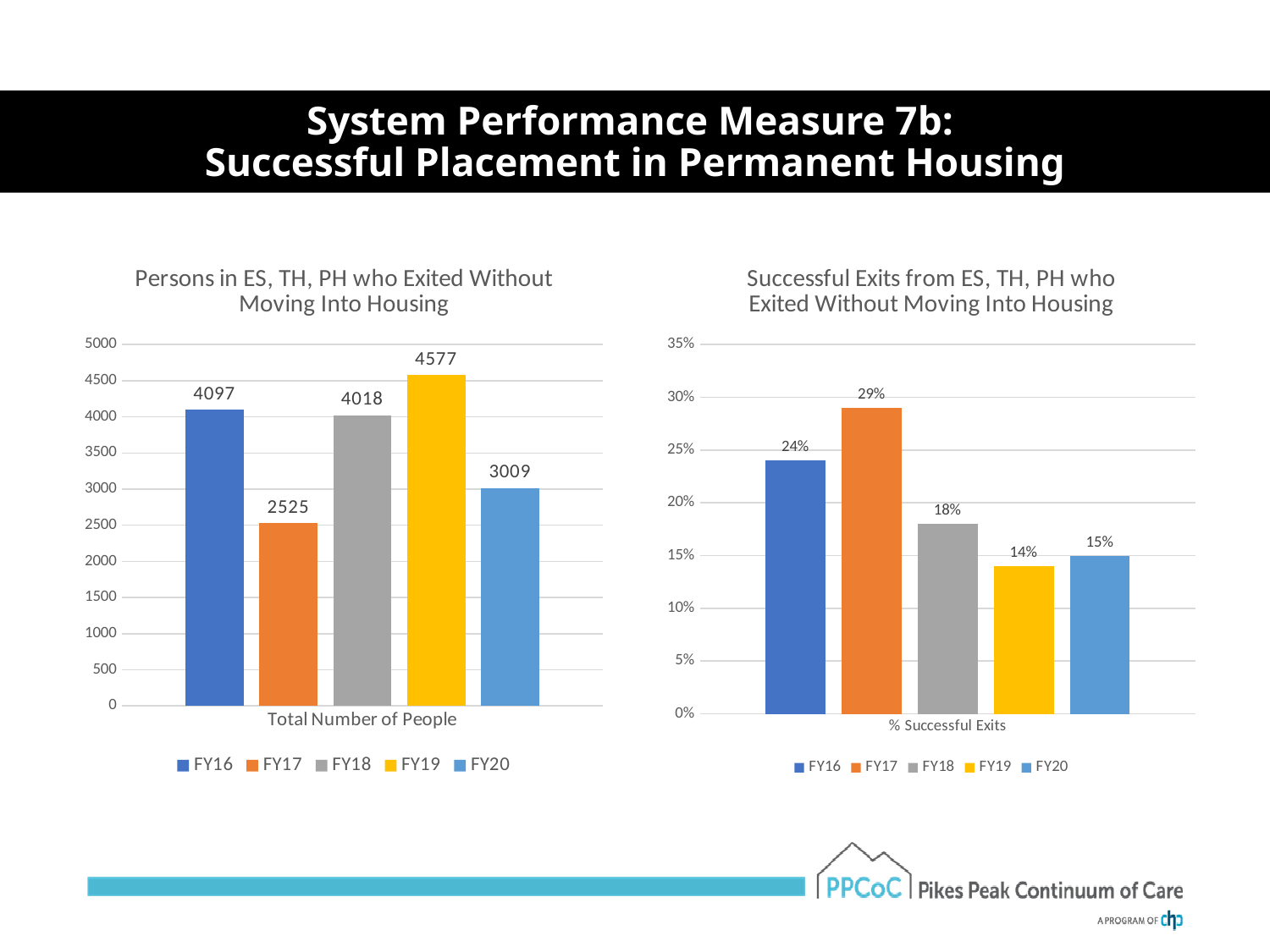
In the left chart (Persons in ES, TH, PH who Exited Without Moving Into Housing), how many series does the legend list? 5 In the right chart (Successful Exits from ES, TH, PH who Exited Without Moving Into Housing), which fiscal year has the highest percentage? FY17 In the left chart (Persons in ES, TH, PH who Exited Without Moving Into Housing), which fiscal year has the highest value? FY19 In the right chart (Successful Exits from ES, TH, PH who Exited Without Moving Into Housing), which fiscal year has the lowest percentage? FY19 In the right chart (Successful Exits from ES, TH, PH who Exited Without Moving Into Housing), what is the difference between the FY16 and FY20 values? 9% In the left chart (Persons in ES, TH, PH who Exited Without Moving Into Housing), what is the difference between the FY19 and FY20 values? 1568 What kind of chart is the right chart (Successful Exits from ES, TH, PH who Exited Without Moving Into Housing)? Bar chart In the left chart (Persons in ES, TH, PH who Exited Without Moving Into Housing), which is larger, FY16 or FY18? FY16 In the right chart (Successful Exits from ES, TH, PH who Exited Without Moving Into Housing), what is the value for FY18? 18% In the right chart (Successful Exits from ES, TH, PH who Exited Without Moving Into Housing), what is the x-axis category label? % Successful Exits In the left chart (Persons in ES, TH, PH who Exited Without Moving Into Housing), what is the value for FY17? 2525 In the left chart (Persons in ES, TH, PH who Exited Without Moving Into Housing), which fiscal year has the lowest value? FY17